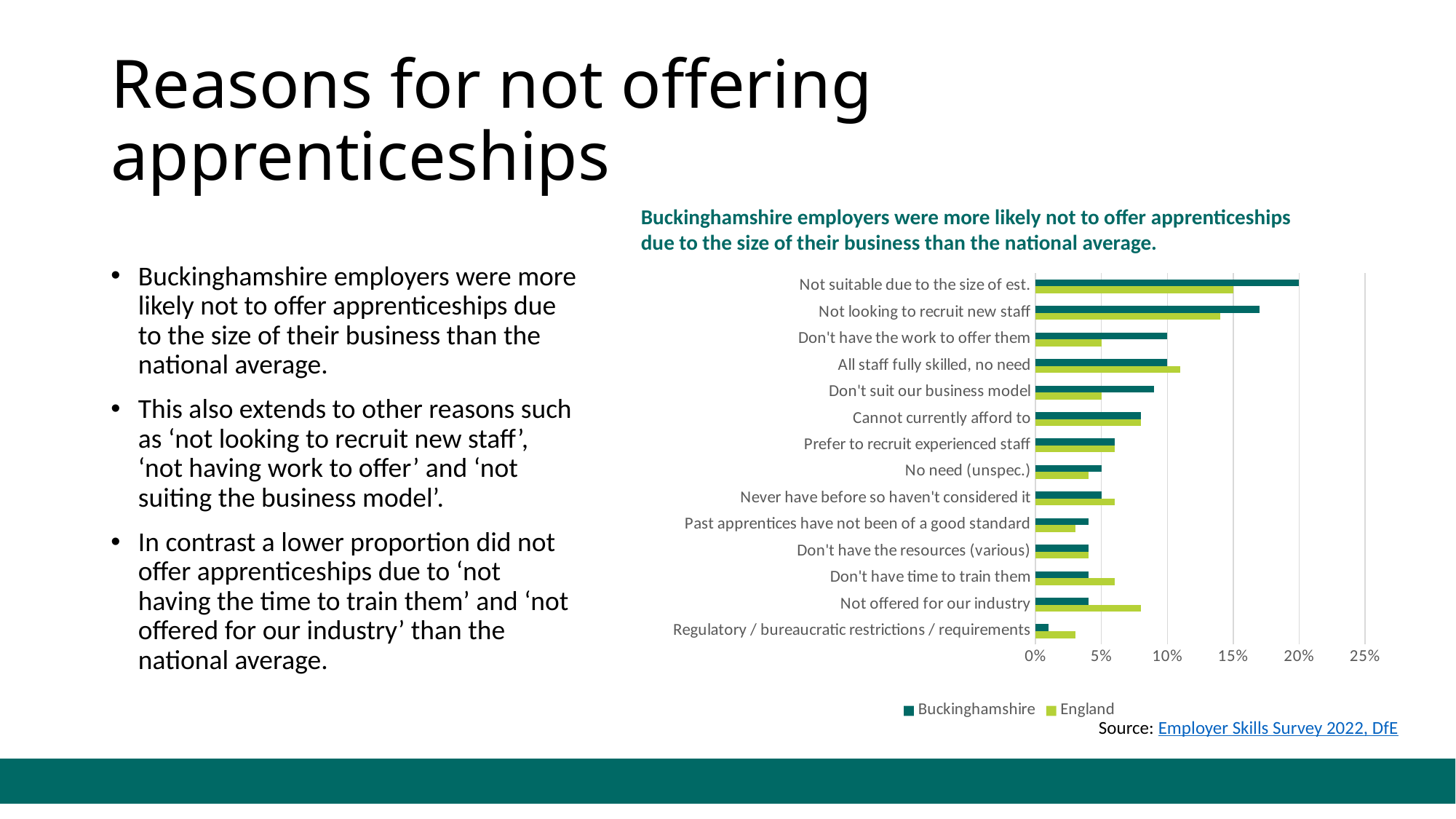
For 'Not offered for our industry', which is larger: the Buckinghamshire value or the England value? England For 'Don't have the work to offer them', which is larger: the Buckinghamshire value or the England value? Buckinghamshire How many reasons (categories) are plotted in the chart? 14 Which reason has the highest Buckinghamshire value? Not suitable due to the size of est. Which series is shown in dark green in the chart? Buckinghamshire Is the England value for 'Not looking to recruit new staff' greater or less than 15%? less What source is cited for the chart? Employer Skills Survey 2022, DfE Is the Buckinghamshire value for 'Not looking to recruit new staff' greater or less than 15%? greater How many series does the chart legend list? 2 Which reason has the lowest Buckinghamshire value? Regulatory / bureaucratic restrictions / requirements What kind of chart is shown on the slide? bar chart Is the Buckinghamshire value for 'Cannot currently afford to' greater or less than 10%? less